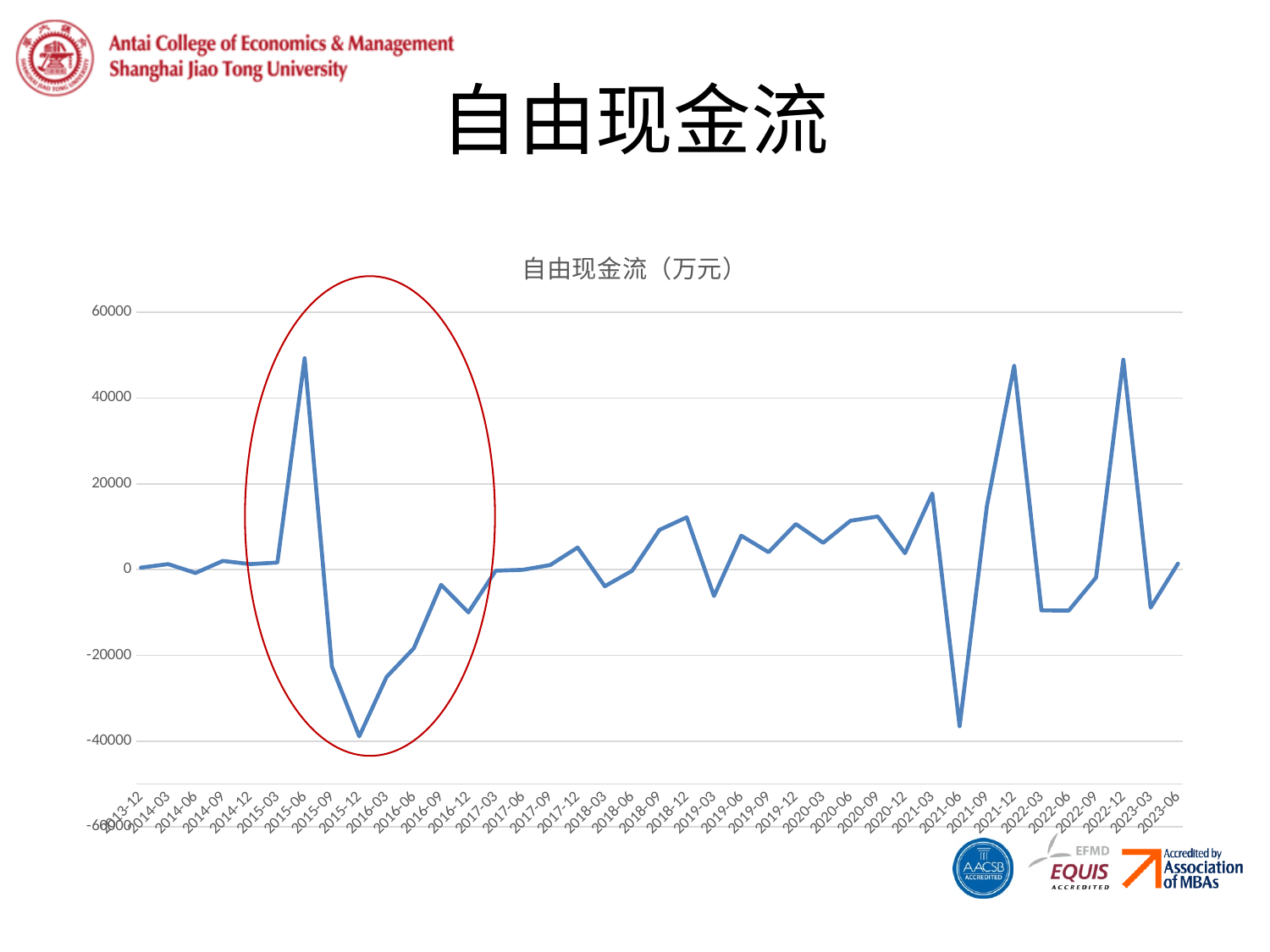
Is the value for 2015-12 greater or less than -20000? less Is the value for 2021-06 greater or less than -20000? less Which has the larger value, 2021-12 or 2021-06? 2021-12 Is the value for 2015-06 greater or less than 40000? greater Which has the larger value, 2015-06 or 2015-12? 2015-06 Does the line rise or fall from 2015-06 to 2015-12? fall How many data points are plotted on the line, from 2013-12 to 2023-06? 39 What kind of chart is shown on the slide? line chart What colour is the plotted line? blue What is the title printed above the chart? 自由现金流（万元）